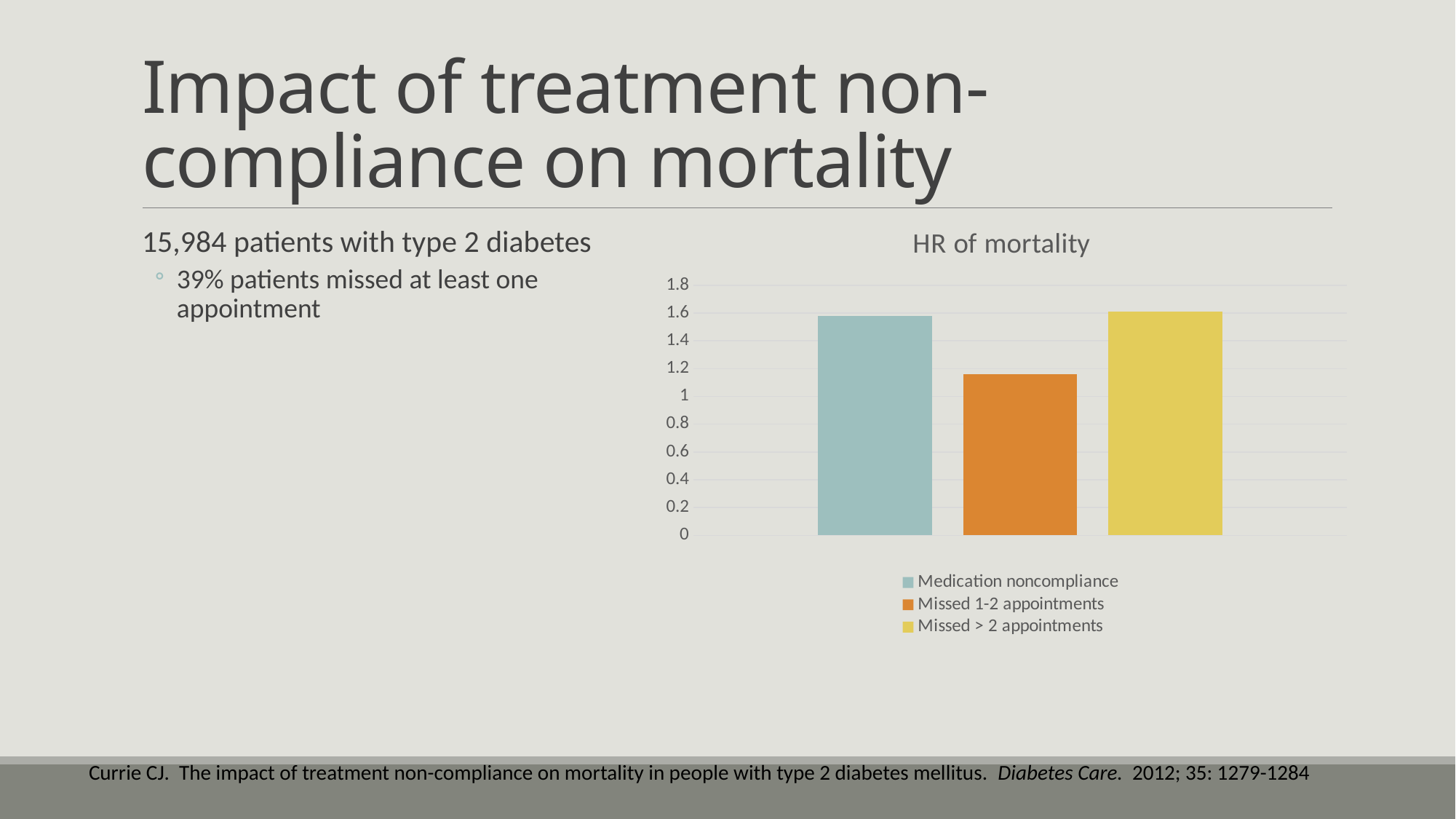
Is the HR of mortality for Missed > 2 appointments greater or less than 1.4? greater Which legend entry is shown in orange in the HR of mortality chart? Missed 1-2 appointments Which has a higher HR of mortality, Medication noncompliance or Missed 1-2 appointments? Medication noncompliance Which category has the lowest HR of mortality? Missed 1-2 appointments How many entries does the legend of the HR of mortality chart list? 3 What kind of chart is shown on the slide? bar chart Is the HR of mortality for Medication noncompliance greater or less than 1.4? greater Is the HR of mortality for Missed 1-2 appointments greater or less than 1? greater How many bars are plotted in the HR of mortality chart? 3 Which has a higher HR of mortality, Missed 1-2 appointments or Missed > 2 appointments? Missed > 2 appointments What is the title of the chart? HR of mortality